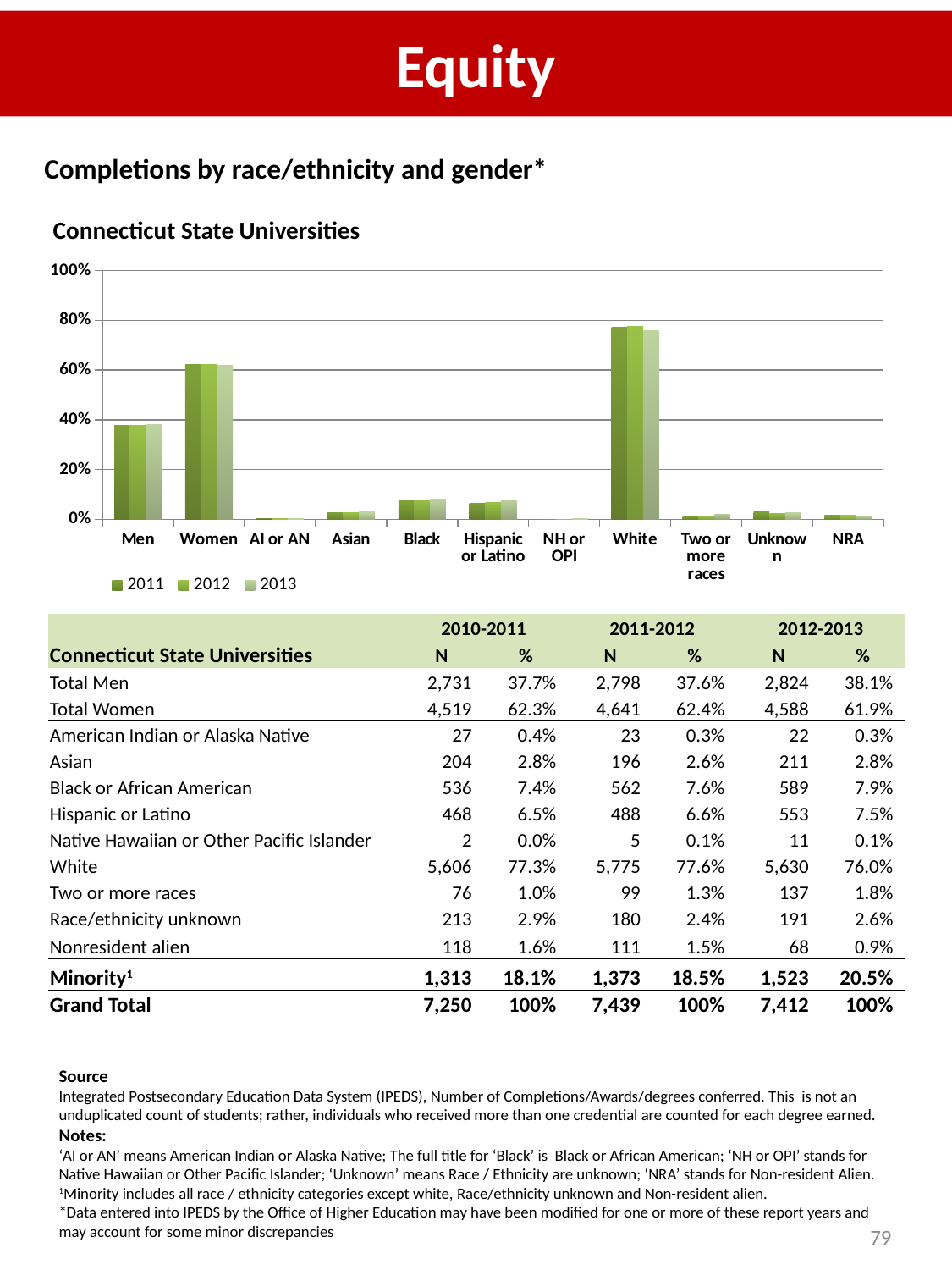
Do the bars for Two or more races rise or fall from 2011 to 2013 in the Connecticut State Universities chart? rise In the Connecticut State Universities chart, which is larger, the 2013 value for Men or the 2013 value for Women? Women In the Connecticut State Universities chart, is the 2011 value for Men greater or less than 40%? less How many series does the legend of the Connecticut State Universities chart list? 3 According to the table, what percentage of Connecticut State Universities completions in 2011-2012 were White? 77.6% Using the table values, what is the difference between the Total Women and Total Men percentages for 2010-2011? 24.6 percentage points In the Connecticut State Universities chart, is the 2011 value for Women greater or less than 60%? greater Which years are listed in the legend of the Connecticut State Universities chart? 2011, 2012, 2013 Which race/ethnicity category has the lowest bars in the Connecticut State Universities chart? NH or OPI What kind of chart is shown for Connecticut State Universities completions by race/ethnicity and gender? Bar chart How many categories are shown along the x axis of the Connecticut State Universities chart? 11 Which category has the tallest bars in the Connecticut State Universities chart? White